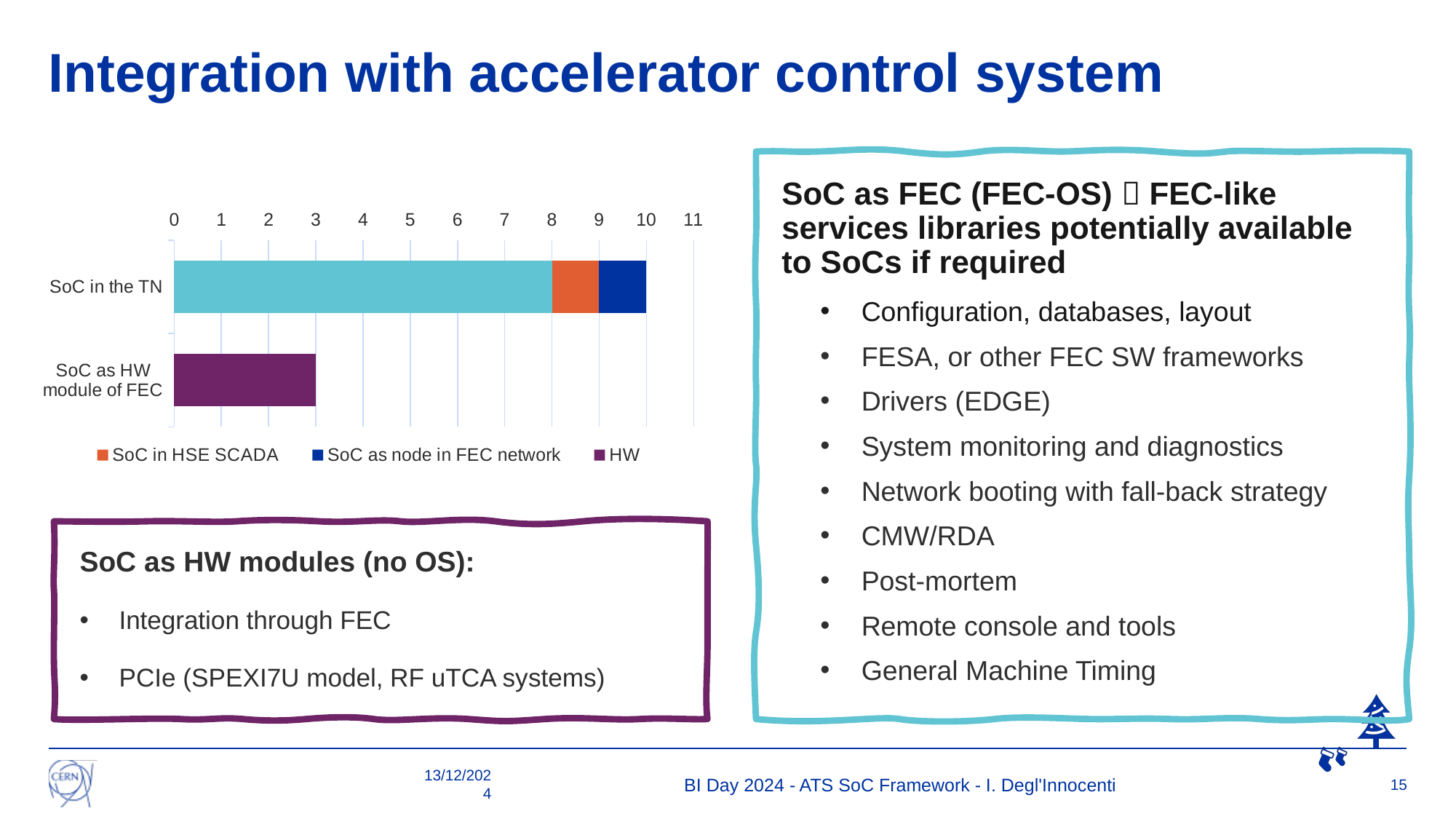
What is the HW value for 'SoC as HW module of FEC'? 3 What is the 'SoC as node in FEC network' value for 'SoC in the TN'? 1 Is the total bar for 'SoC in the TN' greater or less than 8? greater How many categories are shown on the vertical axis of the chart? 2 What kind of chart is shown on the slide? bar chart What is the 'SoC in HSE SCADA' value for 'SoC in the TN'? 1 What is the difference between the total bar for 'SoC in the TN' and the bar for 'SoC as HW module of FEC'? 7 Which category has the longer bar, 'SoC in the TN' or 'SoC as HW module of FEC'? SoC in the TN How many series does the chart legend list? 3 What is the total length of the stacked bar for 'SoC in the TN'? 10 What colour represents the 'HW' series in the chart legend? purple Is the bar for 'SoC as HW module of FEC' greater or less than 5? less